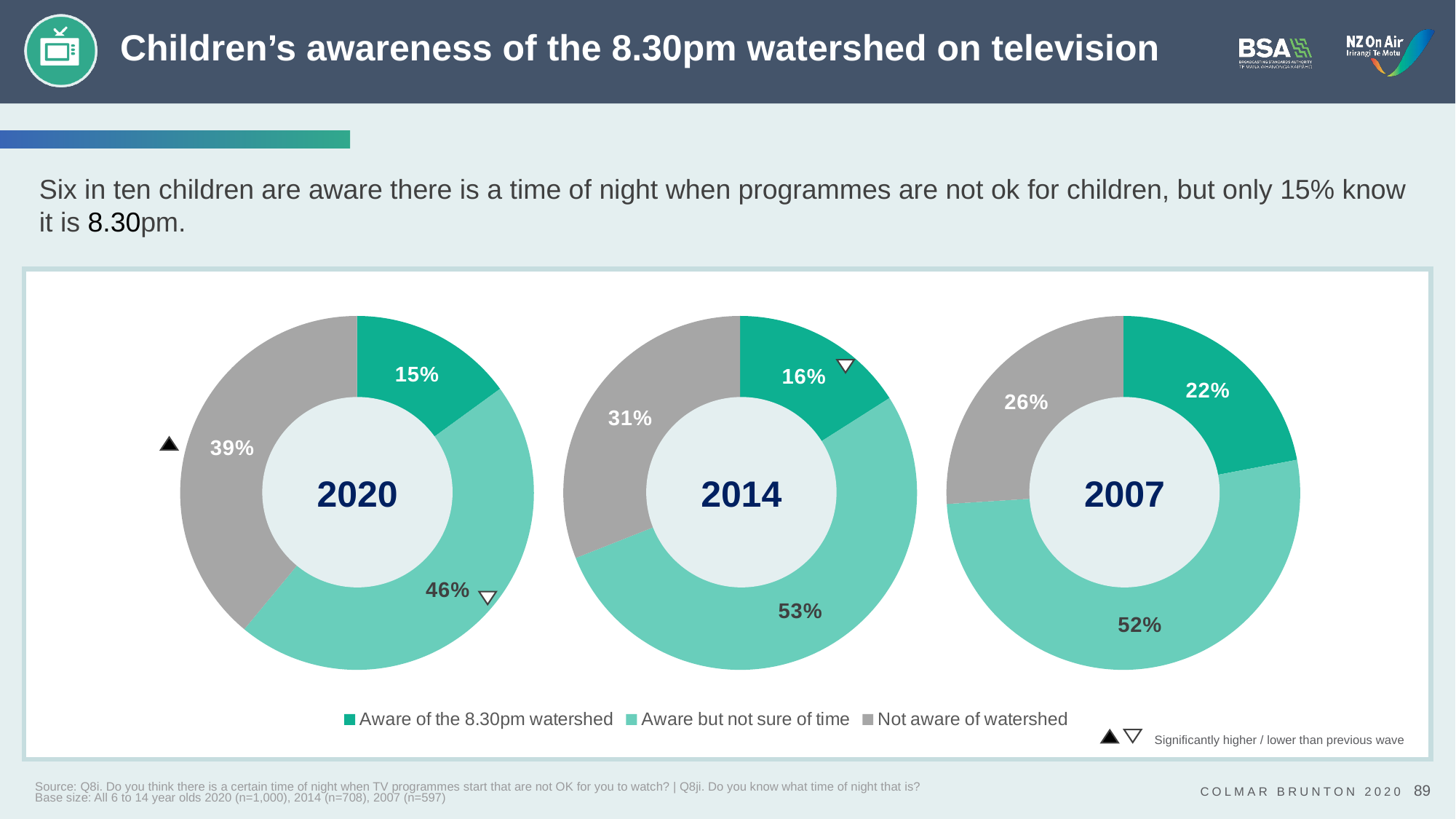
What is the difference between the 'Not aware of watershed' share in 2020 and in 2014? 8 percentage points In the 2007 chart, what percentage of children are aware but not sure of the time? 52% What is the combined share of children who are aware of the watershed (either knowing the time or not) in the 2020 chart? 61% In the 2007 chart, which category has the smallest share? Aware of the 8.30pm watershed Which colour represents 'Not aware of watershed' in the charts? Grey In the 2020 chart, which category has the largest share? Aware but not sure of time In the 2020 chart, what percentage of children are aware of the 8.30pm watershed? 15% How many charts are shown on the slide? 3 What kind of chart is used to show the 2014 data? Doughnut (pie) chart Is the 'Aware of the 8.30pm watershed' share larger in 2007 or in 2020? 2007 How many categories does the legend list? 3 In the 2014 chart, what percentage of children are not aware of the watershed? 31%